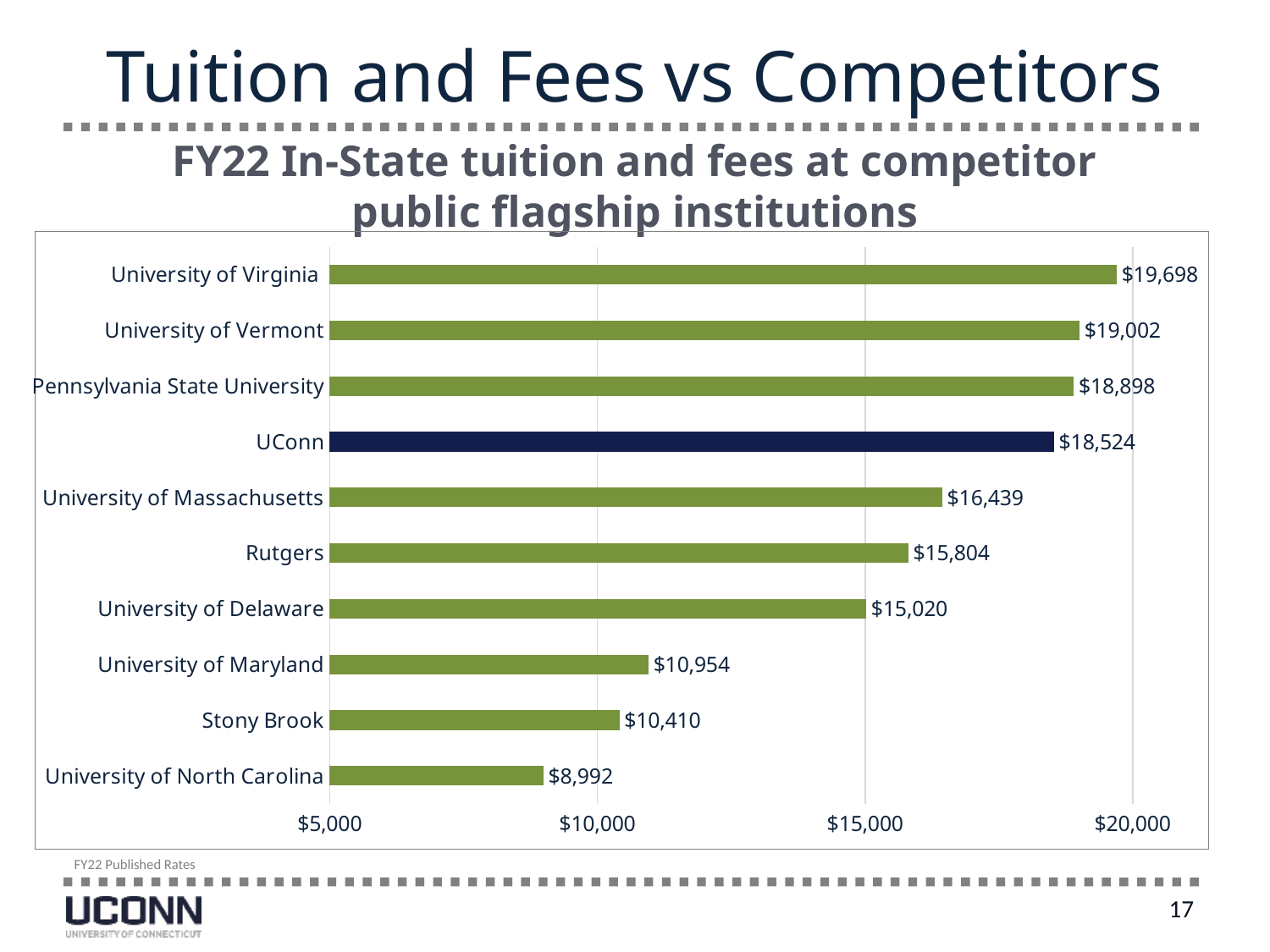
Which is larger, the value for Rutgers or the value for the University of Delaware? Rutgers Which institution has the highest in-state tuition and fees on the chart? University of Virginia What kind of chart is shown on the slide? Bar chart What is the FY22 in-state tuition and fees value for UConn? $18,524 Which institution has the lowest in-state tuition and fees on the chart? University of North Carolina What is the value shown for the University of Massachusetts? $16,439 Is the value for the University of Massachusetts greater or less than $15,000? greater Which bar on the chart is coloured dark navy instead of green? UConn What is the difference between the University of Maryland's value and Stony Brook's value? $544 What is the value shown for Stony Brook? $10,410 How many institutions are shown on the chart? 10 What is the difference between the University of Virginia's value and UConn's value? $1,174